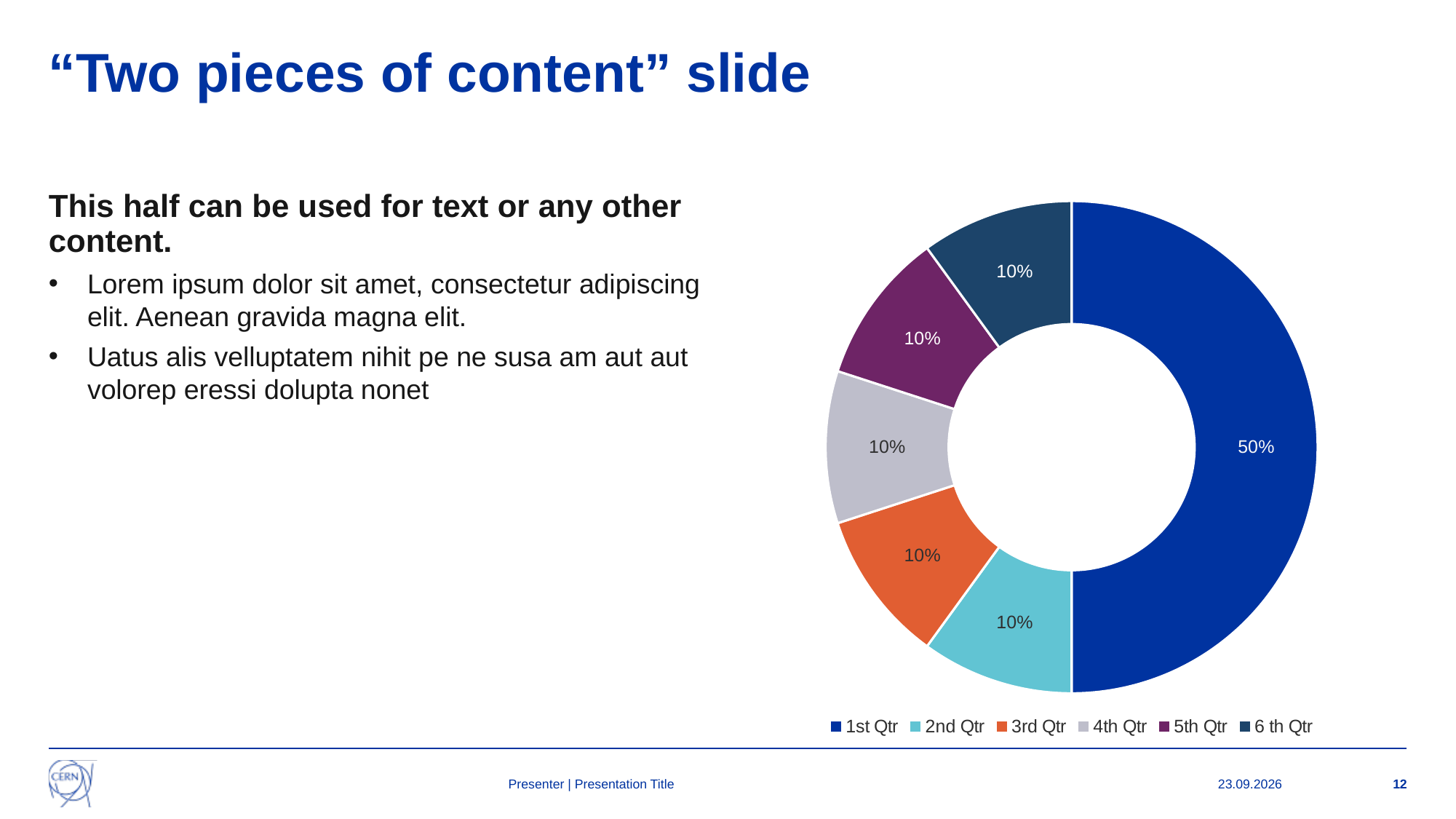
What is the difference between the share for 1st Qtr and the share for 3rd Qtr? 40% Which category has the largest share of the chart? 1st Qtr What is the value shown for 6 th Qtr? 10% What colour is the 3rd Qtr segment? Orange What share of the doughnut chart does 1st Qtr represent? 50% What kind of chart is shown on the slide? Doughnut chart How many categories does the legend list? 6 What is the value shown for 5th Qtr? 10% How many segments show a value of 10%? 5 What is the value shown for 2nd Qtr? 10% Which legend entry is shown in dark blue? 1st Qtr Which is larger, the share for 1st Qtr or the share for 4th Qtr? 1st Qtr